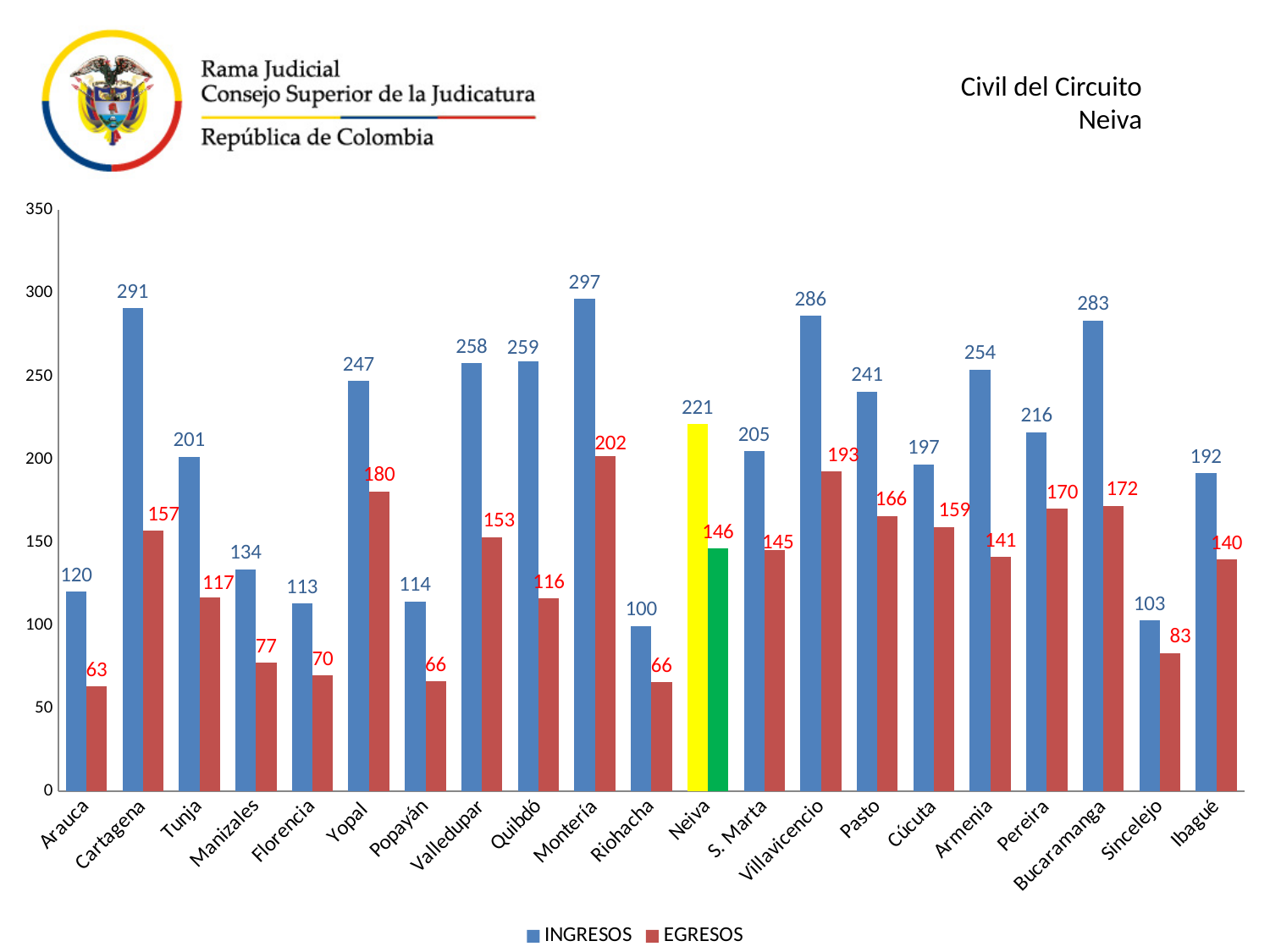
Which city has the lowest INGRESOS value? Riohacha What is the title shown at the top right of the slide? Civil del Circuito Neiva Which city has the lowest EGRESOS value? Arauca What is the EGRESOS value for Villavicencio? 193 How many series does the legend list? 2 Which city has the highest INGRESOS value? Montería How many cities are shown on the x axis? 21 Which is larger, the INGRESOS value for Cartagena or the INGRESOS value for Villavicencio? Cartagena What is the INGRESOS value for Bucaramanga? 283 What is the INGRESOS value for Neiva? 221 What kind of chart is shown on the slide? Bar chart What is the difference between INGRESOS and EGRESOS for Neiva? 75